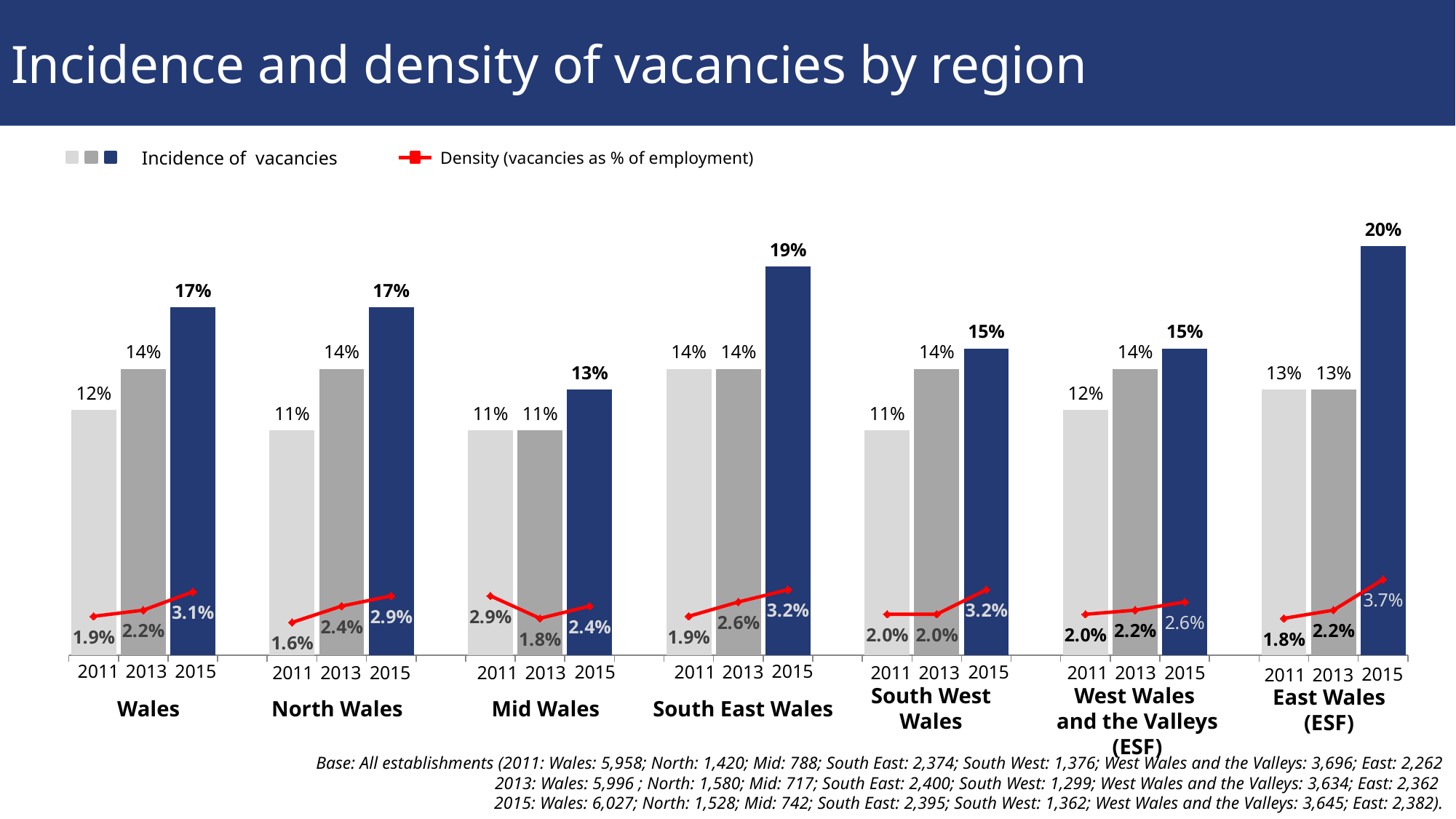
What was the incidence of vacancies in South East Wales in 2015? 19% How many regions (category groups) are shown on the chart? 7 Did the density of vacancies in Mid Wales rise or fall between 2011 and 2013? Fall What colour is the line showing density (vacancies as % of employment)? Red What type of chart is used to show the incidence of vacancies? Bar chart By how many percentage points did the incidence of vacancies in Wales rise between 2011 and 2015? 5 percentage points What is the difference between the 2015 density of vacancies in East Wales (ESF) and in West Wales and the Valleys (ESF)? 1.1 percentage points What was the incidence of vacancies in Mid Wales in 2013? 11% Which region had the lowest incidence of vacancies in 2015? Mid Wales Which region had the highest incidence of vacancies in 2015? East Wales (ESF) What was the density of vacancies (vacancies as % of employment) in North Wales in 2011? 1.6% Which was higher in 2015: the density of vacancies in South East Wales or in North Wales? South East Wales